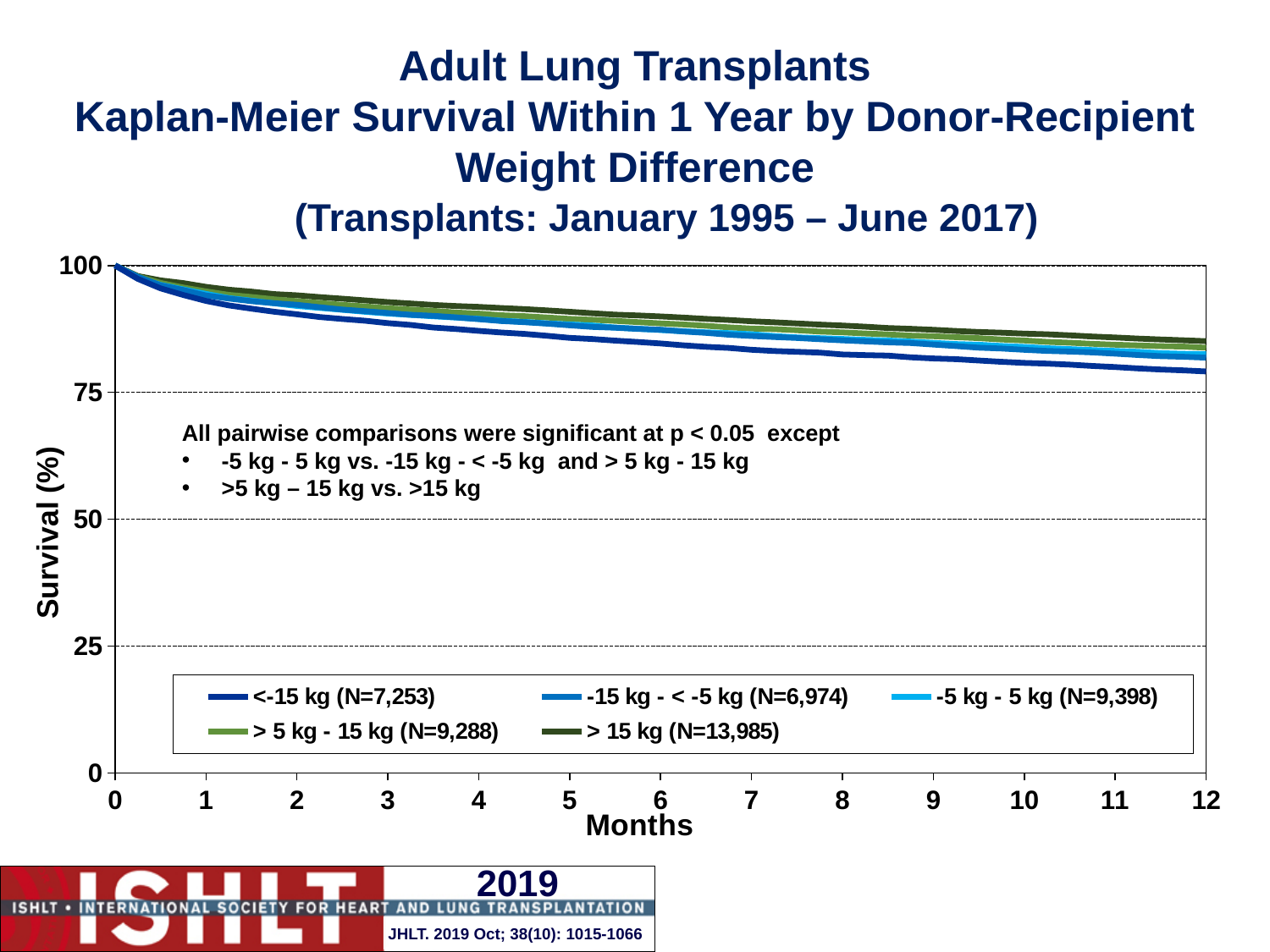
What is the N for the <-15 kg group shown in the legend? 7,253 At 12 months, which group has higher survival: <-15 kg or > 15 kg? > 15 kg Do the survival curves rise or fall as months increase? fall How many series does the legend list? 5 What is the label of the y axis? Survival (%) Is the survival for the <-15 kg group at 12 months greater or less than 75? greater What is the label of the x axis? Months Which weight-difference group has the lowest survival at 12 months? <-15 kg What kind of chart is shown on the slide? line chart Is the survival for the > 15 kg group at 12 months greater or less than 100? less What is the N for the > 15 kg group shown in the legend? 13,985 What is the survival value for all groups at month 0? 100